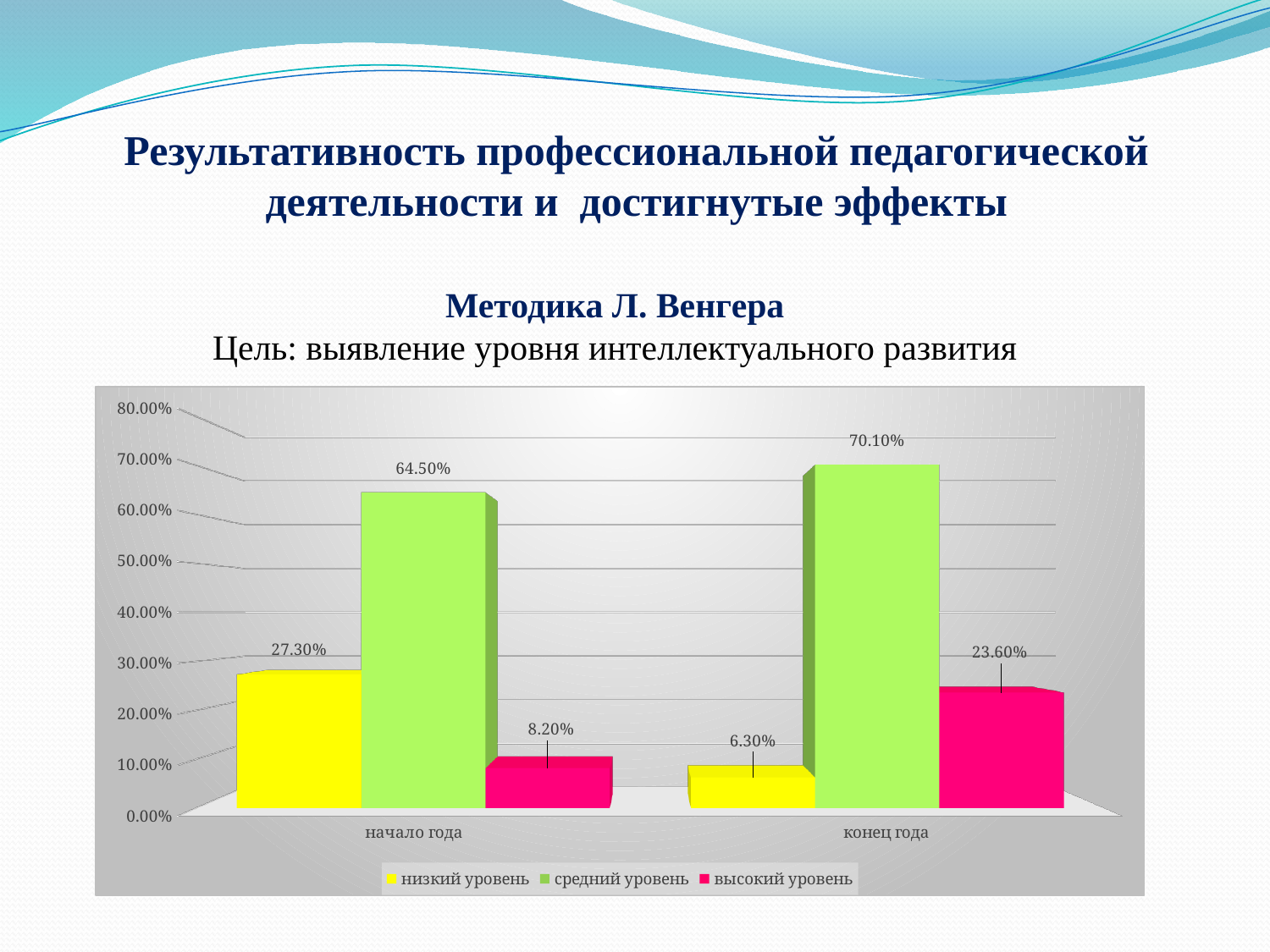
How many series does the legend list? 3 How many categories are shown on the x axis? 2 Which series has the highest value at конец года? средний уровень What is the value for низкий уровень at конец года? 6.30% What is the value for высокий уровень at начало года? 8.20% Does the value for низкий уровень rise or fall from начало года to конец года? fall Which series has the lowest value at начало года? высокий уровень What is the difference between the средний уровень values at конец года and начало года? 5.60% Which is larger: высокий уровень at конец года or низкий уровень at начало года? низкий уровень at начало года What kind of chart is shown on the slide? bar chart What is the value for средний уровень at конец года? 70.10% What is the value for низкий уровень at начало года? 27.30%